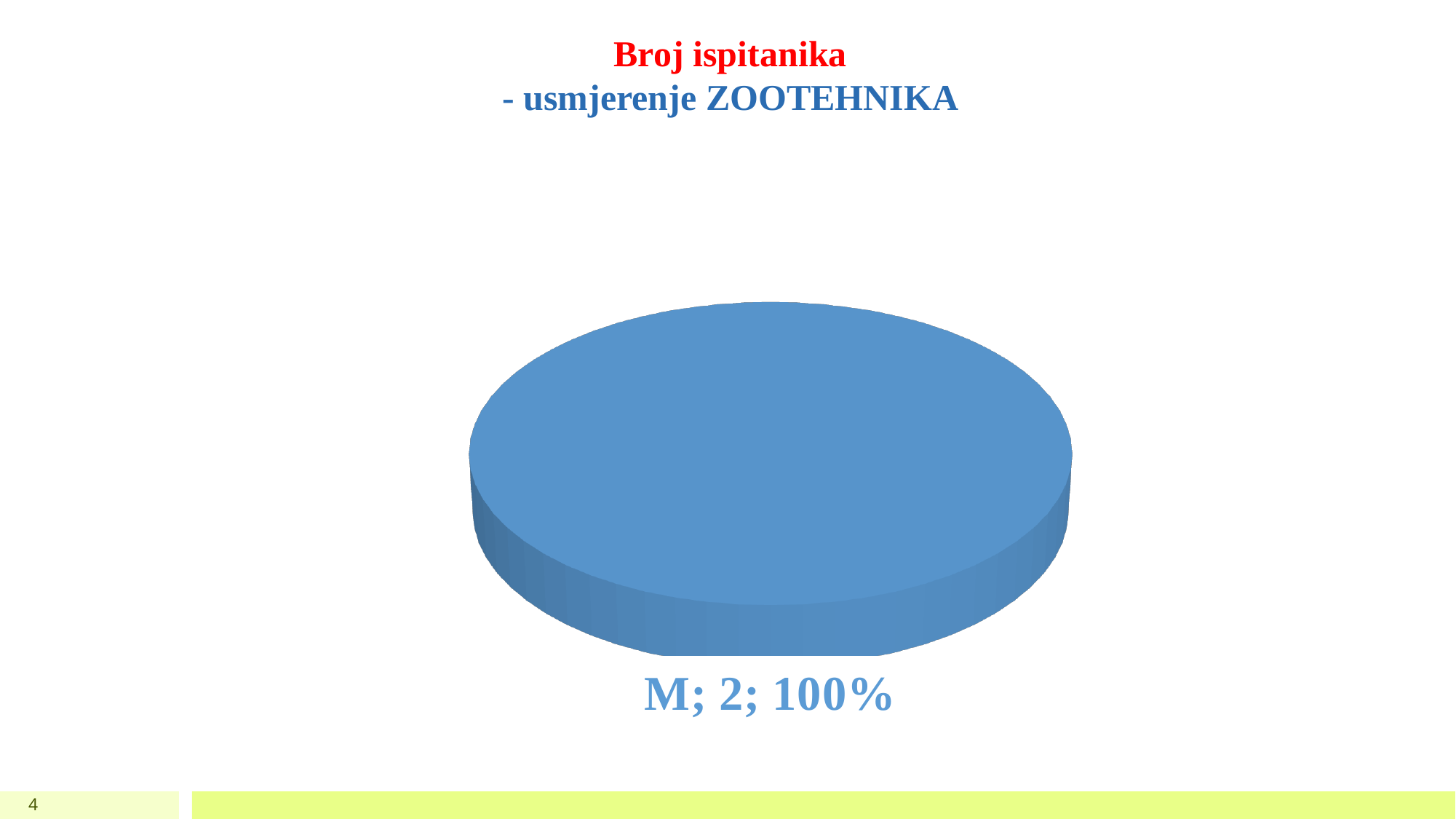
What kind of chart is shown on the slide? pie chart How many slices does the pie chart have? 1 What share of the pie does the M slice represent? 100% What is the value for M in the pie chart? 2 Which category is shown in the pie chart? M What is the title of the chart? Broj ispitanika - usmjerenje ZOOTEHNIKA